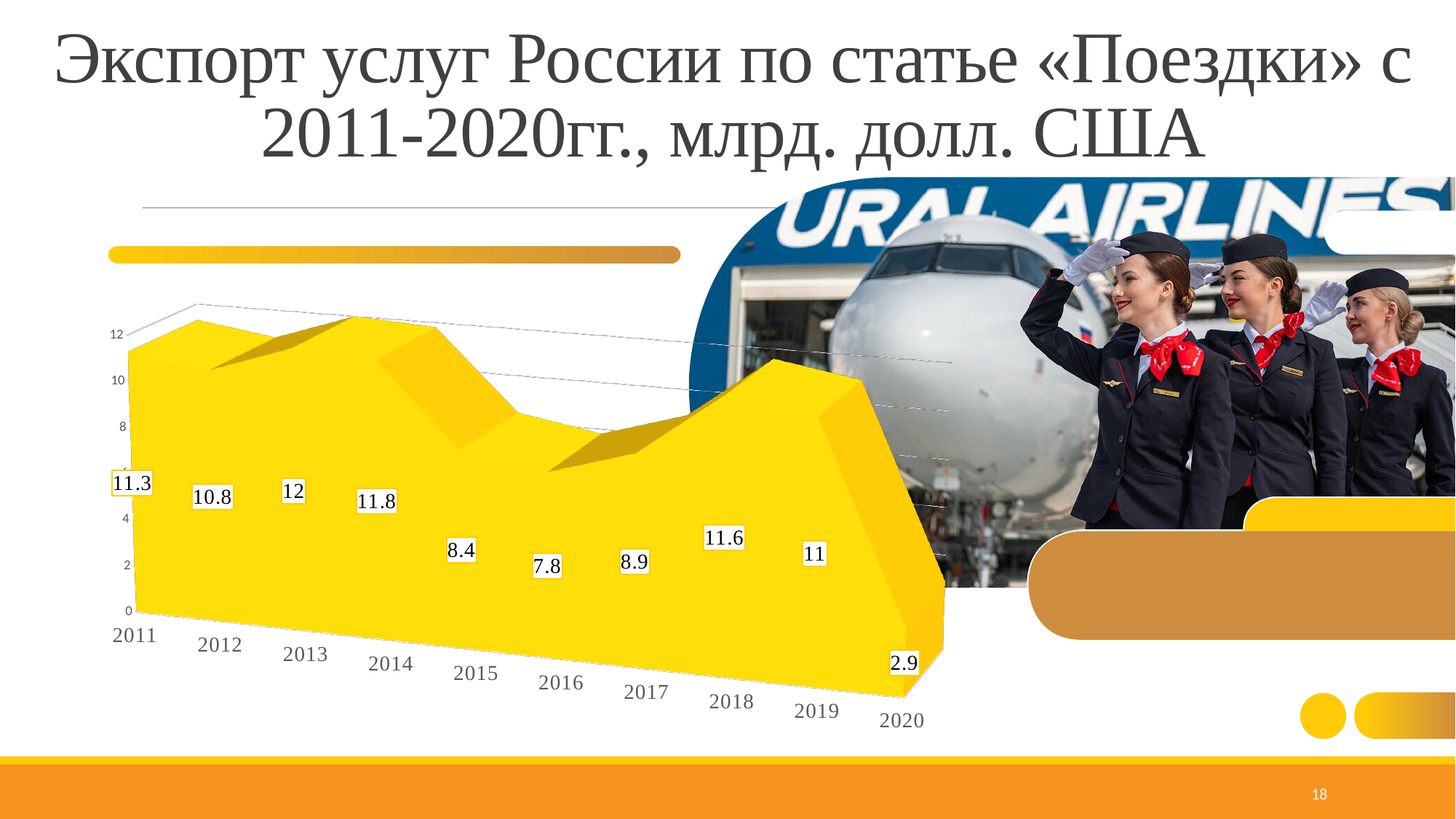
What is the value for 2015? 8.4 Which year has the highest value? 2013 Which is larger, the value for 2014 or the value for 2017? 2014 What is the value for 2018? 11.6 What is the difference between the values for 2013 and 2016? 4.2 Do the values rise or fall from 2018 to 2020? Fall What kind of chart is shown on the slide? Area chart Which year has the lowest value? 2020 What is the value for 2011? 11.3 What is the difference between the values for 2019 and 2020? 8.1 How many years are plotted on the chart? 10 What is the value for 2020? 2.9